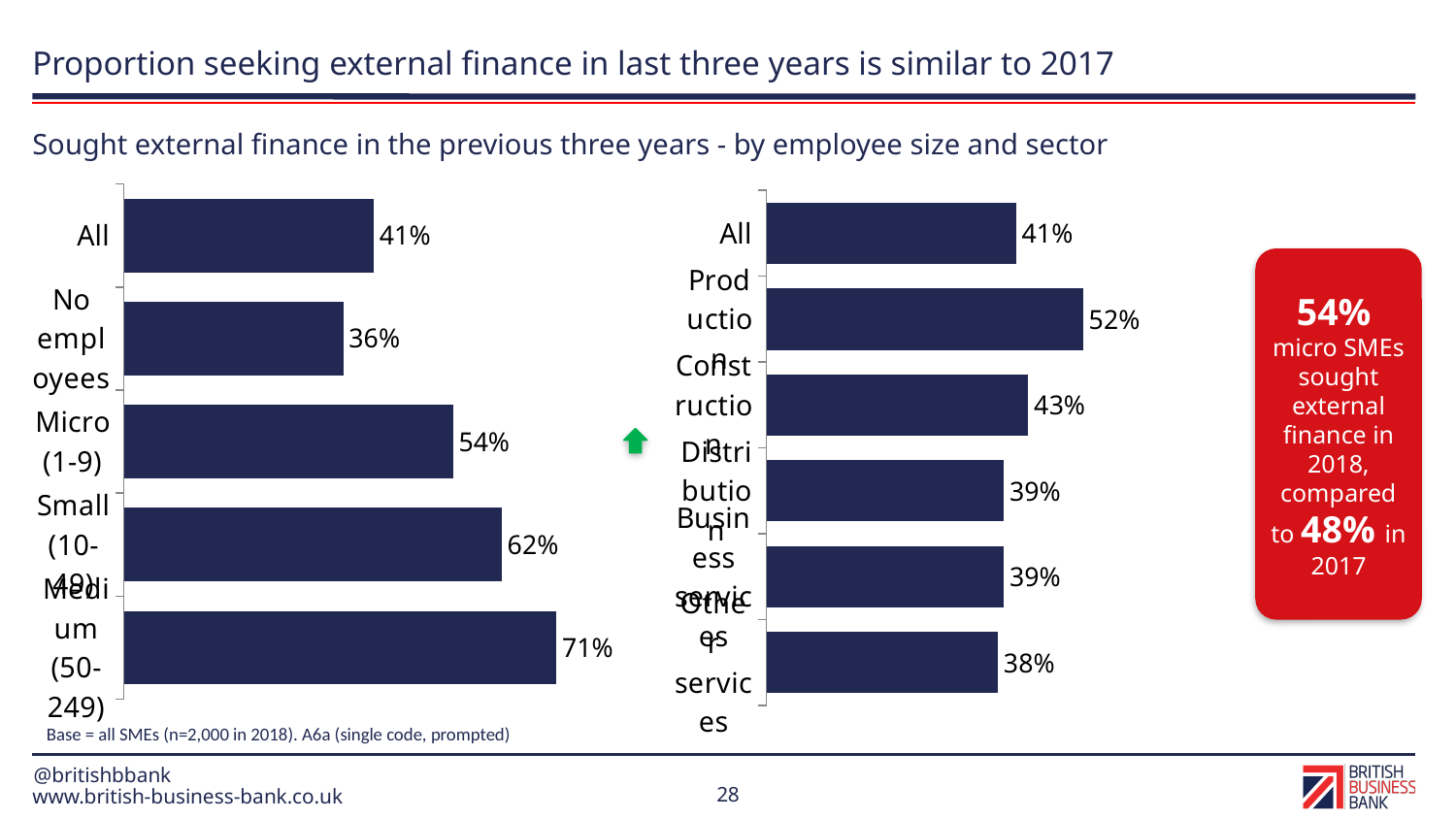
In the left chart (by employee size), how many categories are shown? 5 In the right chart (by sector), what is the value for Production? 52% In the left chart (by employee size), which category has the lowest value? No employees In the right chart (by sector), which is larger, the value for Production or the value for Construction? Production In the left chart (by employee size), what percentage of Micro (1-9) SMEs sought external finance? 54% In the left chart (by employee size), what is the difference between Small (10-49) and No employees? 26 percentage points What type of chart is used on the left of the slide? Bar chart In the left chart (by employee size), what is the value for Medium (50-249)? 71% In the right chart (by sector), what is the difference between Production and Other services? 14 percentage points In the right chart (by sector), which sector has the highest value? Production In the left chart (by employee size), which category has the highest value? Medium (50-249) In the right chart (by sector), what is the value for Construction? 43%